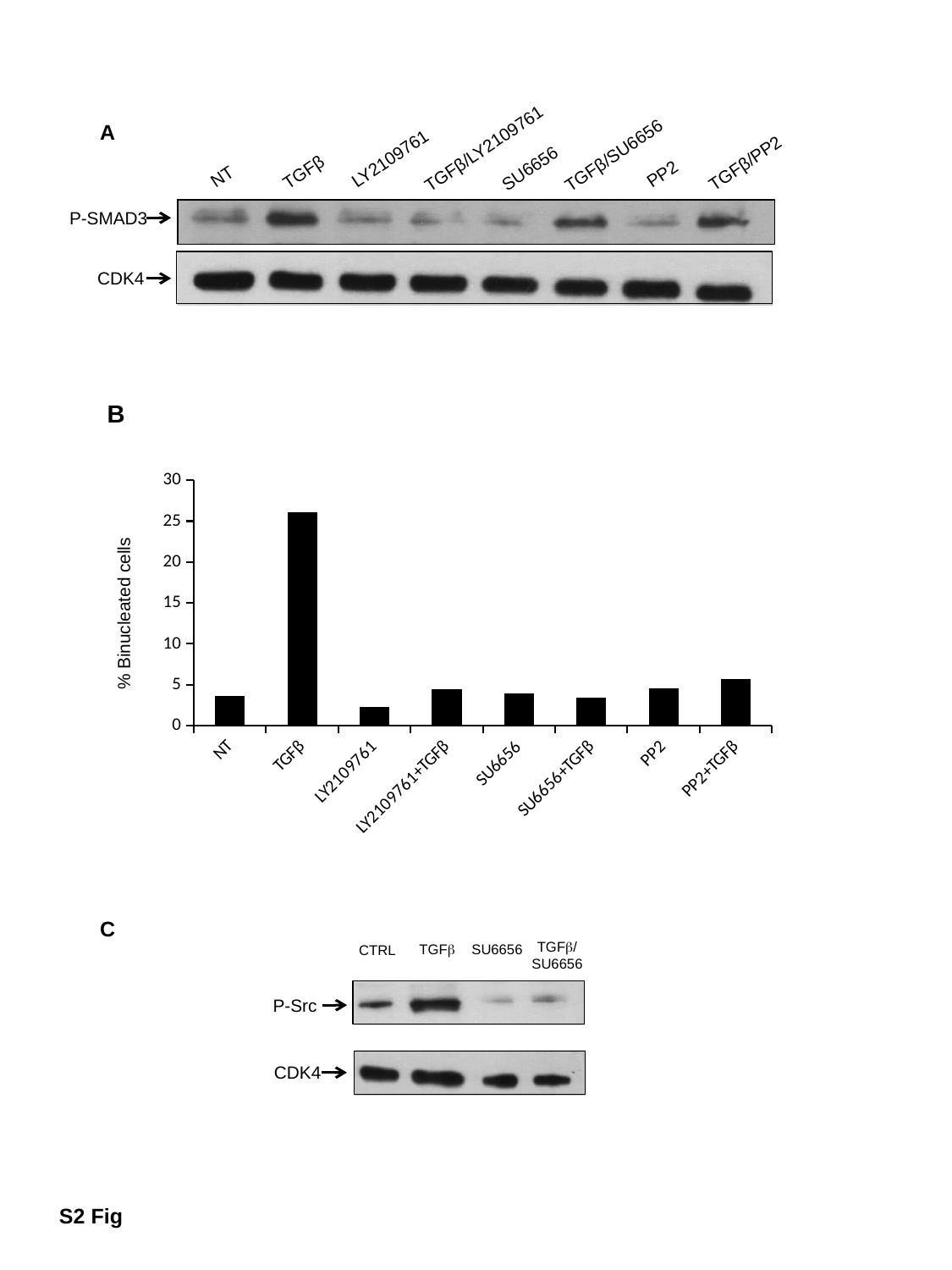
In the bar chart in panel B, is the value for SU6656+TGFβ greater or less than 10? less In the bar chart in panel B, is the value for NT greater or less than 5? less What is the y-axis label of the chart in panel B? % Binucleated cells In the bar chart in panel B, is the value for TGFβ greater or less than 20? greater How many categories are shown on the x axis of the bar chart in panel B? 8 In the bar chart in panel B, which category has the highest percentage of binucleated cells? TGFβ In the bar chart in panel B, which category has the lowest percentage of binucleated cells? LY2109761 In the bar chart in panel B, which is larger, the value for PP2+TGFβ or the value for PP2? PP2+TGFβ What kind of chart is shown in panel B? bar chart In the bar chart in panel B, which is larger, the value for TGFβ or the value for NT? TGFβ